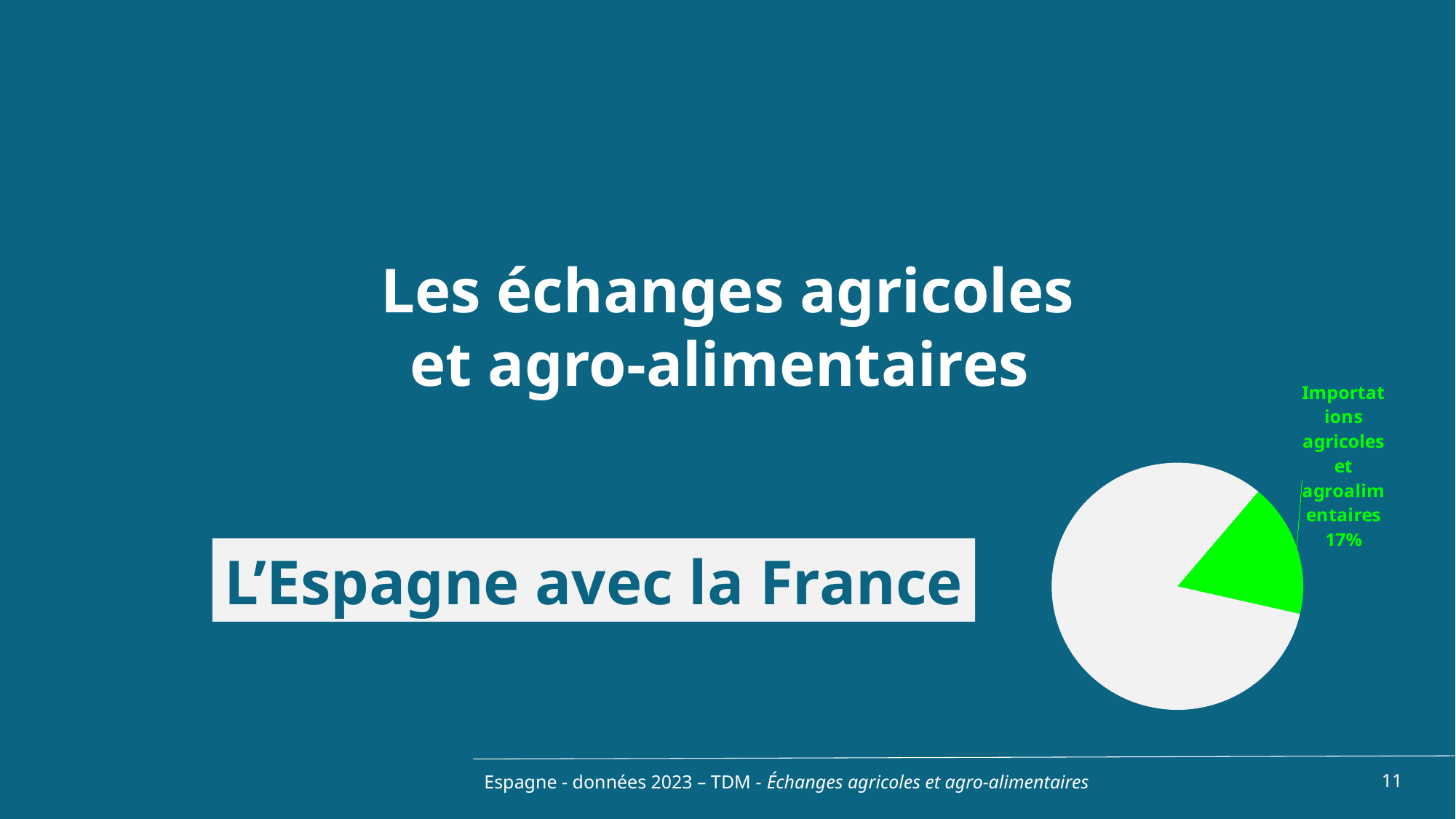
What colour is the slice labelled "Importations agricoles et agroalimentaires" in the pie chart? green What share of the pie does the slice labelled "Importations agricoles et agroalimentaires" represent? 17% Which slice of the pie chart has a data label printed next to it? Importations agricoles et agroalimentaires How many slices does the pie chart have? 2 Is the green slice of the pie chart larger or smaller than the white slice? smaller What kind of chart is shown on the right of the slide? pie chart Is the share of the slice labelled "Importations agricoles et agroalimentaires" greater or less than 50%? less